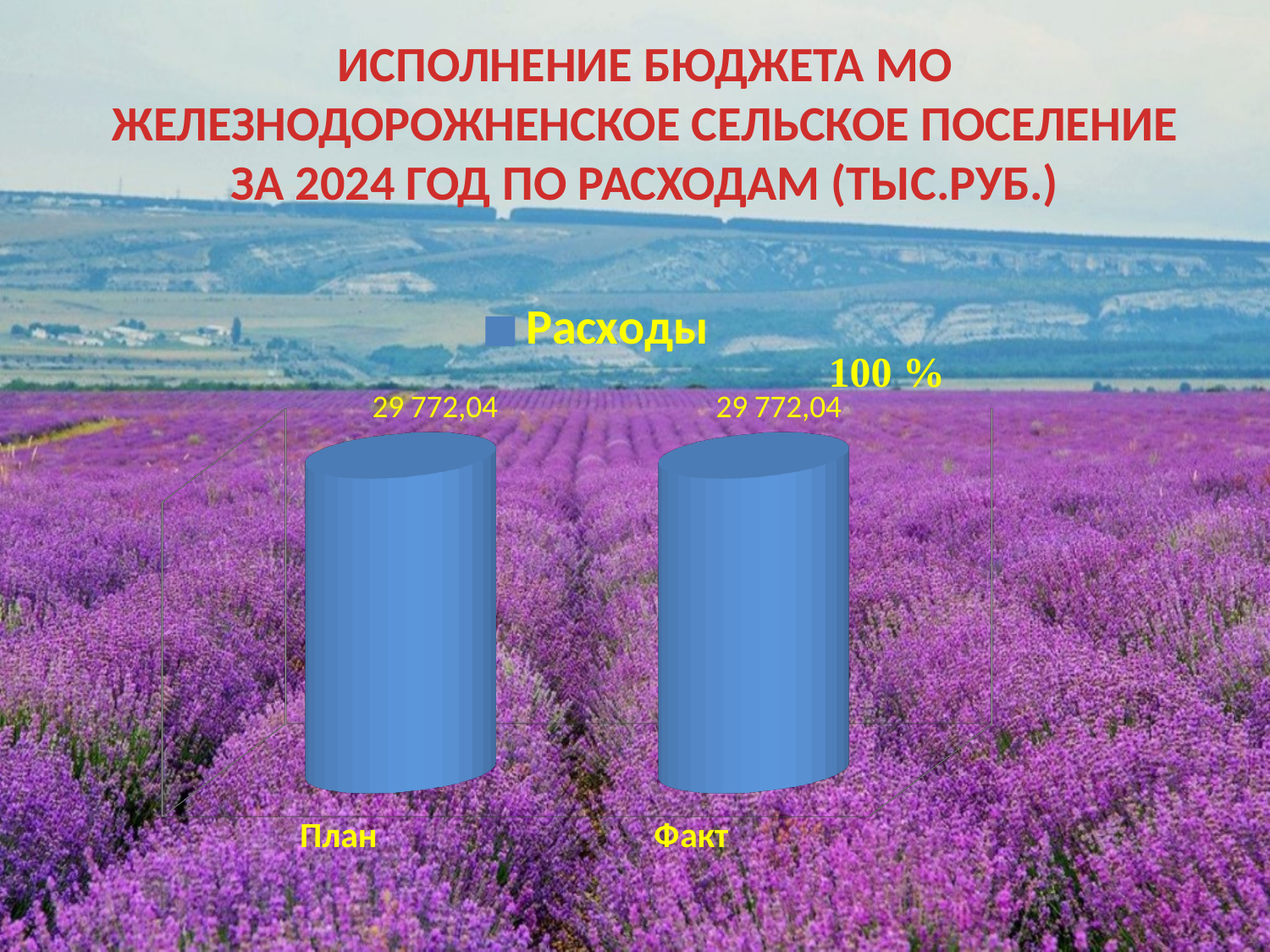
How many series does the legend list? 1 What kind of chart is shown on the slide? bar chart What is the difference between the values for План and Факт? 0 Is the value for План larger than, smaller than, or equal to the value for Факт? equal What is the name of the series shown in the legend? Расходы What is the value for План? 29 772,04 What percentage is printed above the Факт bar? 100 % What is the value for Факт? 29 772,04 What are the labels of the two categories on the x axis? План, Факт How many categories are shown on the chart? 2